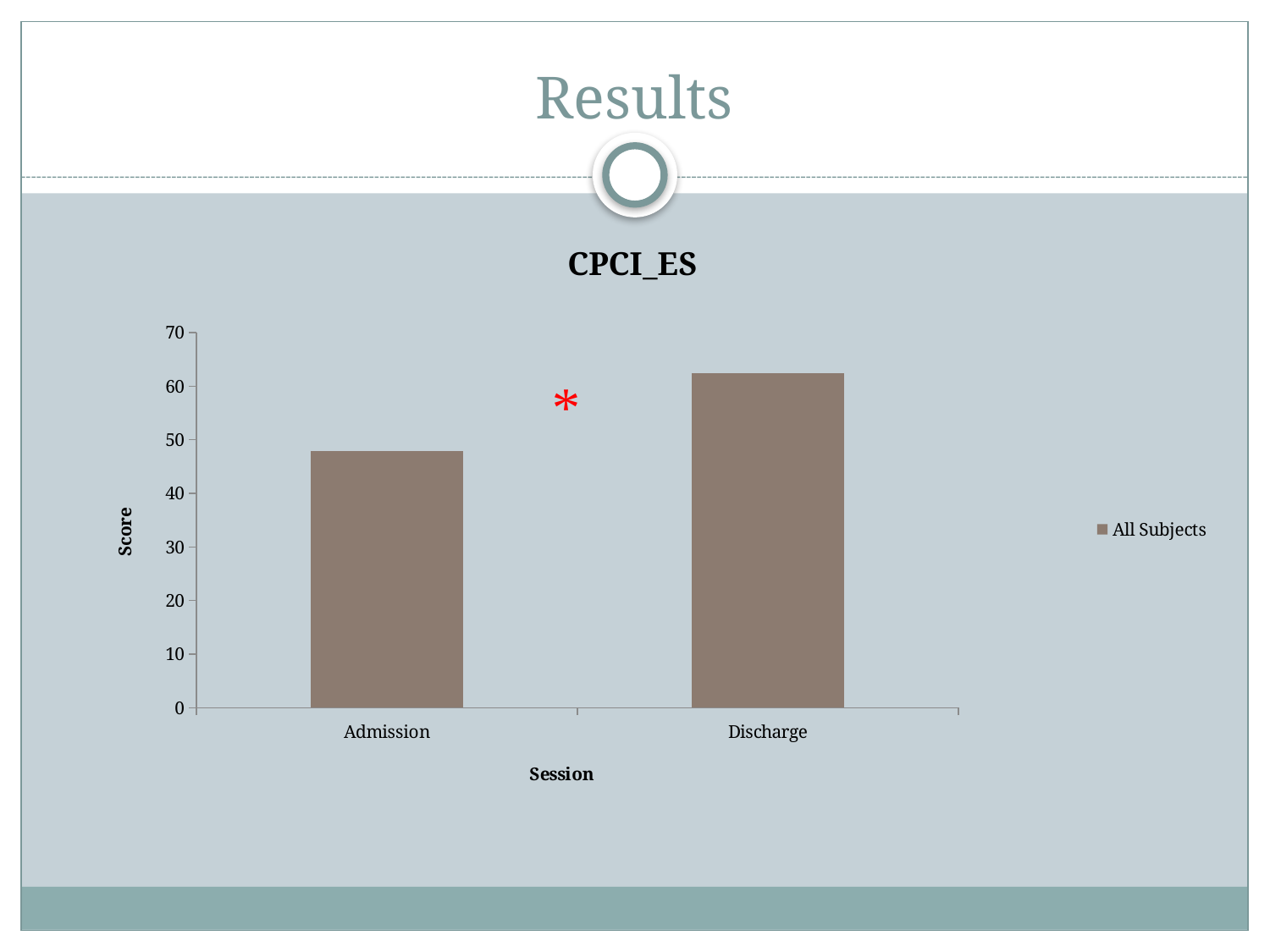
How many series does the legend list? 1 What is the label of the y axis? Score Which session has the lowest score? Admission Do the scores rise or fall from Admission to Discharge? rise Is the score for Admission greater or less than 50? less Is the score for Discharge greater or less than 60? greater What is the title of the chart? CPCI_ES Which session has the highest score? Discharge How many categories are shown on the x axis? 2 What type of chart is shown on the slide? bar chart Which is larger, the score at Admission or at Discharge? Discharge Is the score for Admission greater or less than 40? greater